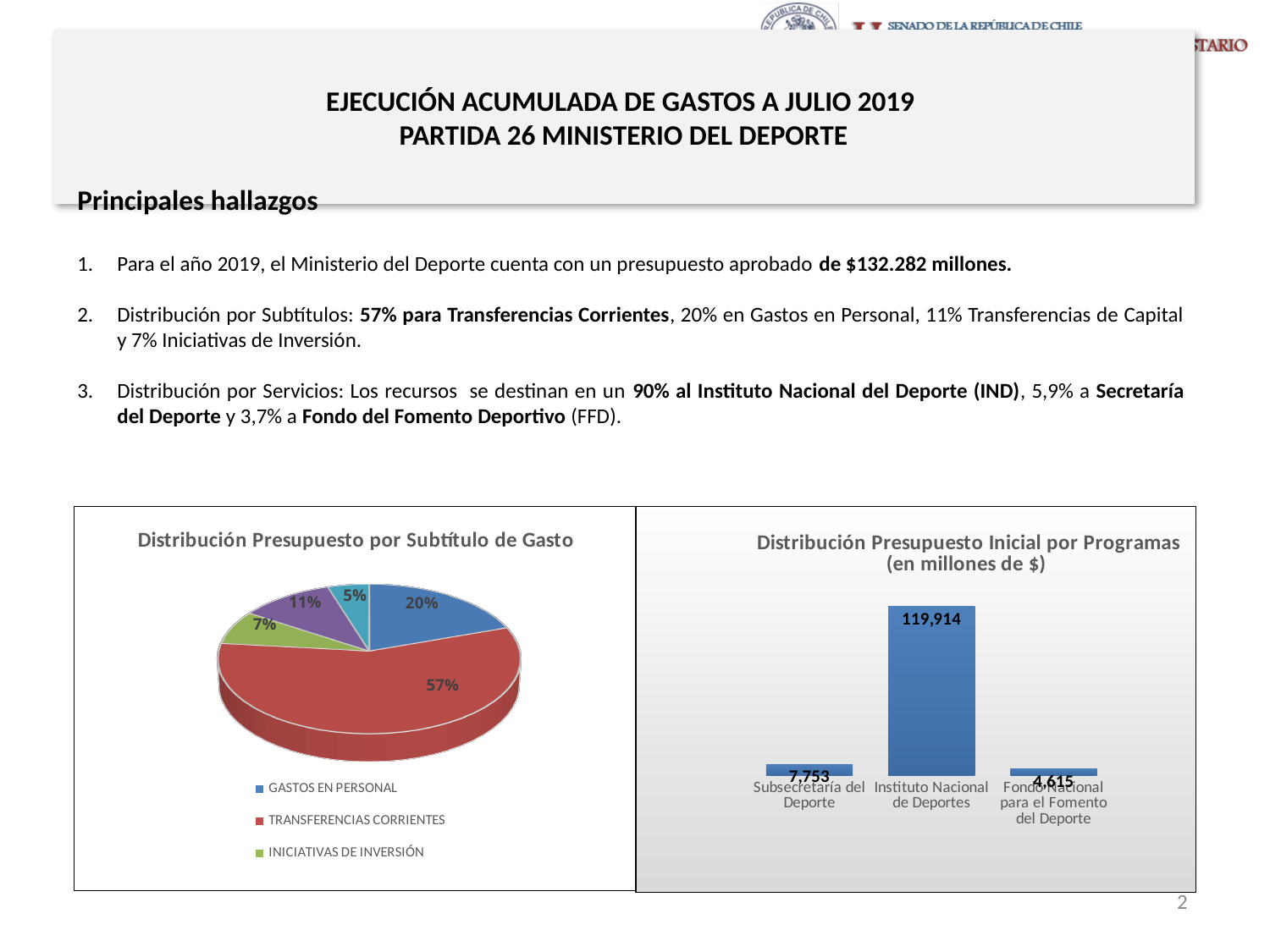
In the pie chart 'Distribución Presupuesto por Subtítulo de Gasto', what share is shown for INICIATIVAS DE INVERSIÓN? 7% In the chart 'Distribución Presupuesto Inicial por Programas', what is the value for Subsecretaría del Deporte? 7,753 In the chart 'Distribución Presupuesto Inicial por Programas', what is the value for Instituto Nacional de Deportes? 119,914 How many entries does the legend of the chart 'Distribución Presupuesto por Subtítulo de Gasto' list? 3 In the chart 'Distribución Presupuesto Inicial por Programas', which program has the lowest value? Fondo Nacional para el Fomento del Deporte What kind of chart is 'Distribución Presupuesto Inicial por Programas'? Bar chart In the pie chart 'Distribución Presupuesto por Subtítulo de Gasto', what share is shown for GASTOS EN PERSONAL? 20% What kind of chart is 'Distribución Presupuesto por Subtítulo de Gasto'? Pie chart In the pie chart 'Distribución Presupuesto por Subtítulo de Gasto', what share is shown for TRANSFERENCIAS CORRIENTES? 57% In the chart 'Distribución Presupuesto Inicial por Programas', what is the difference between Subsecretaría del Deporte and Fondo Nacional para el Fomento del Deporte? 3,138 In the pie chart 'Distribución Presupuesto por Subtítulo de Gasto', which legend category has the largest slice? TRANSFERENCIAS CORRIENTES In the chart 'Distribución Presupuesto Inicial por Programas', what is the value for Fondo Nacional para el Fomento del Deporte? 4,615